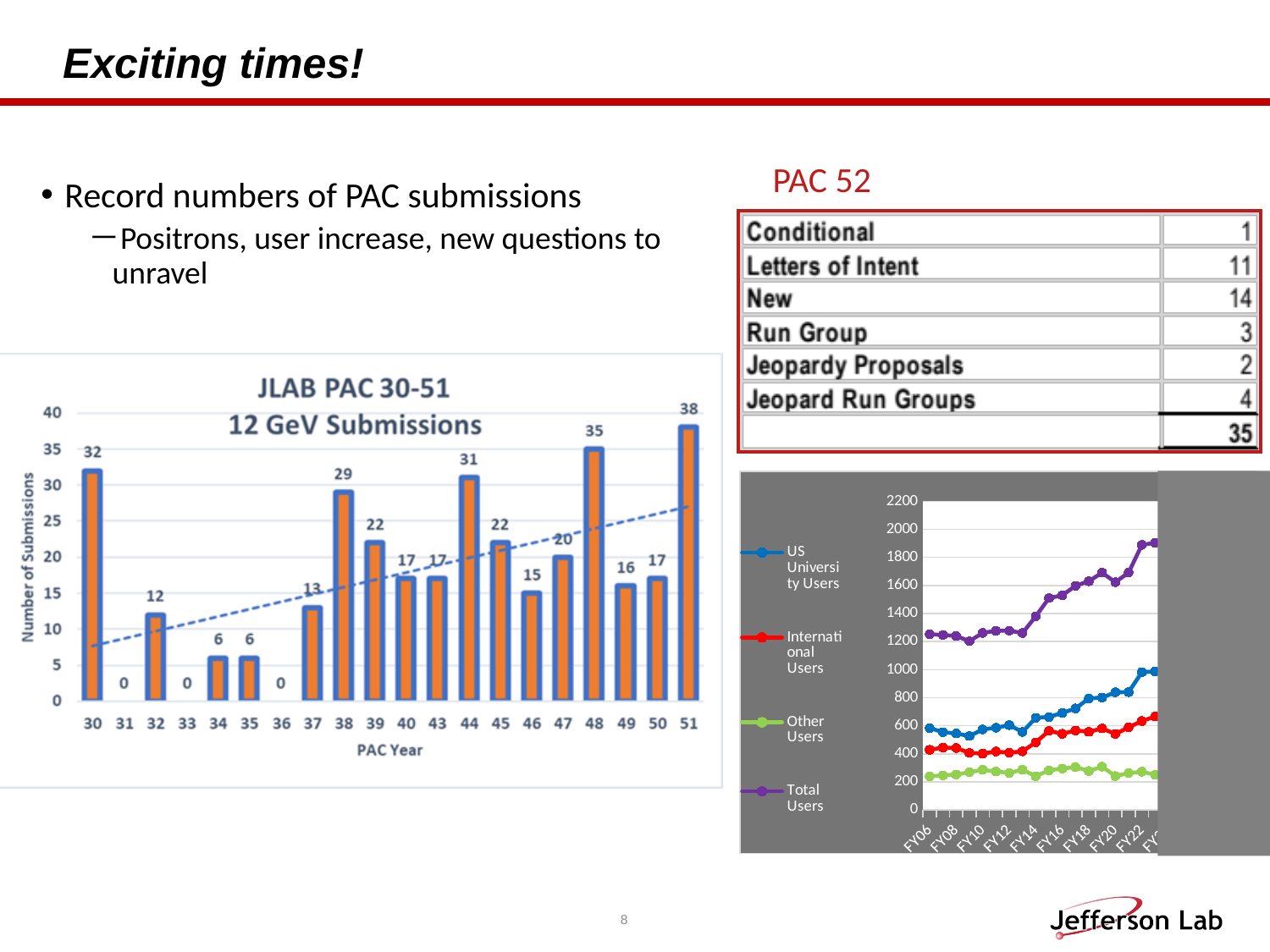
In the users line chart at the bottom right, is the value for Other Users at FY06 greater or less than 400? less In the JLAB PAC 30-51 12 GeV Submissions chart, which has more submissions, PAC year 44 or PAC year 45? PAC year 44 In the JLAB PAC 30-51 12 GeV Submissions chart, what is the difference in submissions between PAC year 48 and PAC year 49? 19 In the JLAB PAC 30-51 12 GeV Submissions chart, how many PAC years are shown on the x axis? 20 In the JLAB PAC 30-51 12 GeV Submissions chart, how many submissions were there for PAC year 34? 6 What kind of chart is the JLAB PAC 30-51 12 GeV Submissions chart? Bar chart In the users line chart at the bottom right, how many series does the legend list? 4 In the JLAB PAC 30-51 12 GeV Submissions chart, how many submissions were there for PAC year 51? 38 In the users line chart at the bottom right, is the value for Total Users at FY22 greater or less than 1800? greater In the JLAB PAC 30-51 12 GeV Submissions chart, which PAC year has the highest number of submissions? 51 In the JLAB PAC 30-51 12 GeV Submissions chart, how many submissions were there for PAC year 38? 29 In the users line chart at the bottom right, do the US University Users values generally rise or fall from FY06 to FY22? Rise